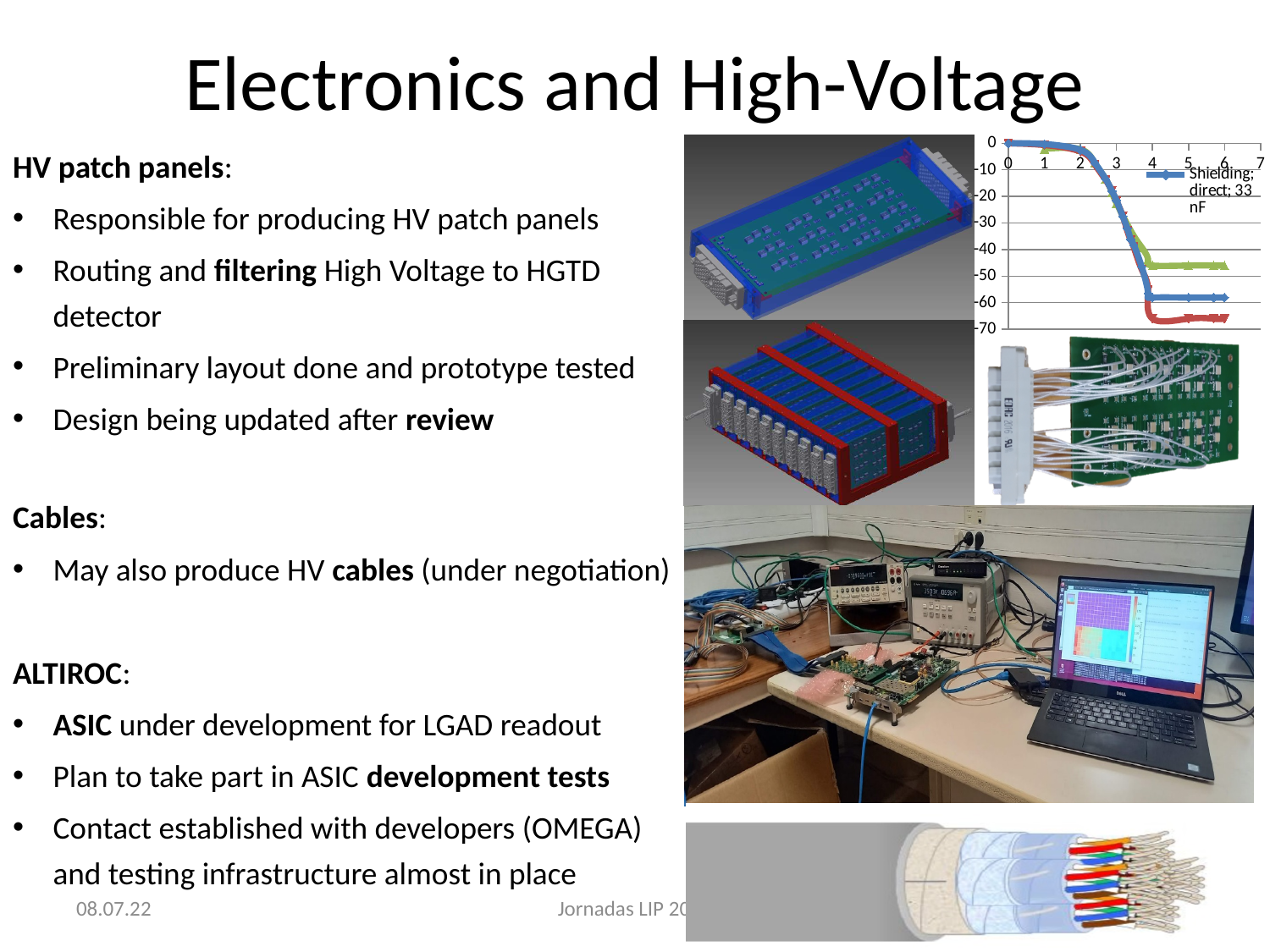
In the line chart, at x = 6, which series has the higher value: the 'Shielding; direct; 33 nF' series or the red series? Shielding; direct; 33 nF In the line chart, is the value of the 'Shielding; direct; 33 nF' series at x = 6 greater or less than -50? less In the line chart, is the value of the red series at x = 6 greater or less than -60? less What kind of chart is shown in the top right of the slide? line chart In the line chart, is the value of the 'Shielding; direct; 33 nF' series at x = 1 greater or less than -10? greater What is the highest value shown on the x axis of the line chart? 7 In the line chart, do the plotted values rise or fall as the x axis increases? fall In the line chart, at x = 6, which series has the higher value: the green series or the red series? the green series What is the lowest value shown on the y axis of the line chart? -70 What is the legend entry readable in the line chart? Shielding; direct; 33 nF